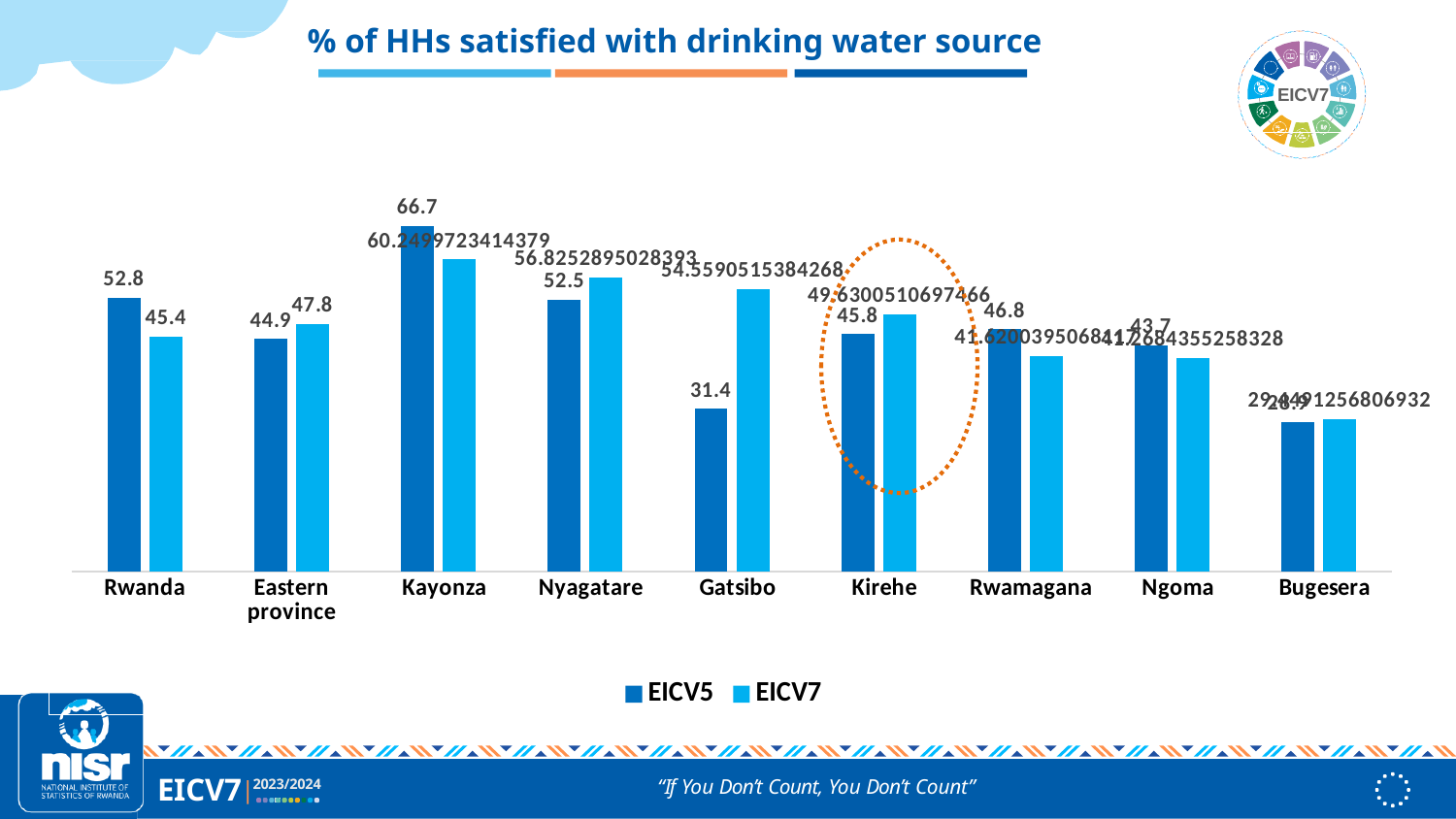
What is the difference between the EICV5 and EICV7 values for Rwanda? 7.4 How many series does the legend list? 2 What is the EICV5 value for Gatsibo? 31.4 For Eastern province, which is larger: the EICV5 value or the EICV7 value? EICV7 Which category has the highest EICV5 value? Kayonza How many categories are shown on the x axis? 9 Which category has the lowest EICV5 value? Bugesera What is the EICV7 value for Rwanda? 45.4 What is the title of the chart? % of HHs satisfied with drinking water source What is the EICV5 value for Rwanda? 52.8 What kind of chart is shown on the slide? Bar chart For Gatsibo, which is larger: the EICV5 value or the EICV7 value? EICV7